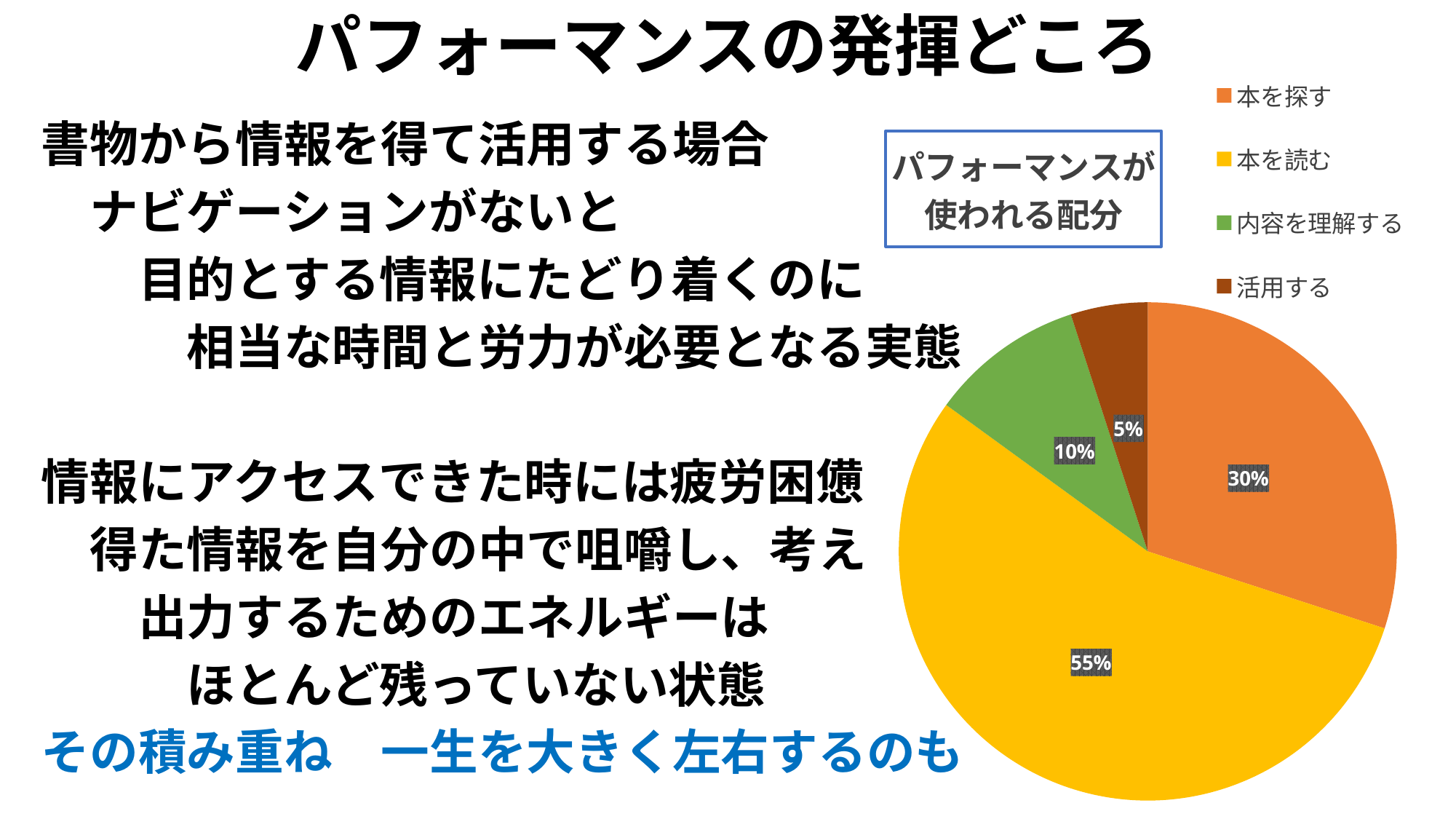
What percentage of the pie is 内容を理解する? 10% What is the title shown in the box above the pie chart? パフォーマンスが使われる配分 How many categories does the pie chart have? 4 What colour is the slice for 本を読む? yellow What kind of chart is shown on the slide? pie chart Which category has the smallest share of the pie? 活用する What percentage of the pie is 活用する? 5% Which category has the largest share of the pie? 本を読む Which is larger, the share for 内容を理解する or the share for 活用する? 内容を理解する What percentage of the pie is 本を探す? 30% What percentage of the pie is 本を読む? 55% What is the difference in percentage points between 本を読む and 本を探す? 25